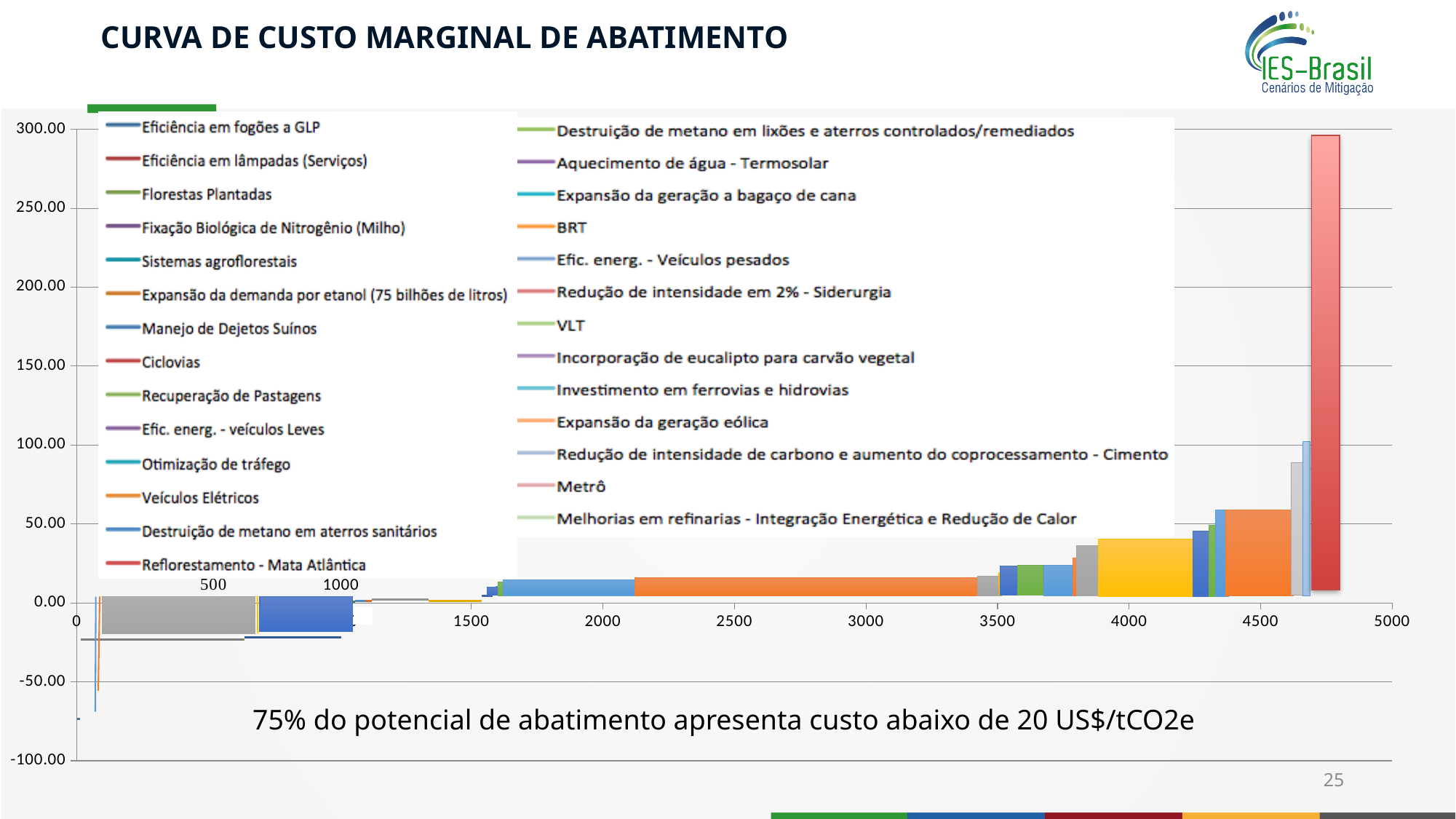
How many entries does the chart's legend list? 27 According to the text on the chart, what share of the abatement potential has a cost below 20 US$/tCO2e? 75% What is the highest value shown on the x axis? 5000 What is the highest value shown on the y axis? 300.00 Is the value of the wide grey bar near the left of the chart (around 100 to 650 on the x axis) greater or less than 0? less Is the value of the wide orange bar spanning roughly 2100 to 3400 on the x axis greater or less than 50? less Do the bar heights generally rise or fall moving from left to right along the x axis? rise Is the value of the wide yellow bar spanning roughly 3900 to 4200 on the x axis greater or less than 50? less What kind of chart is shown on the slide? bar chart